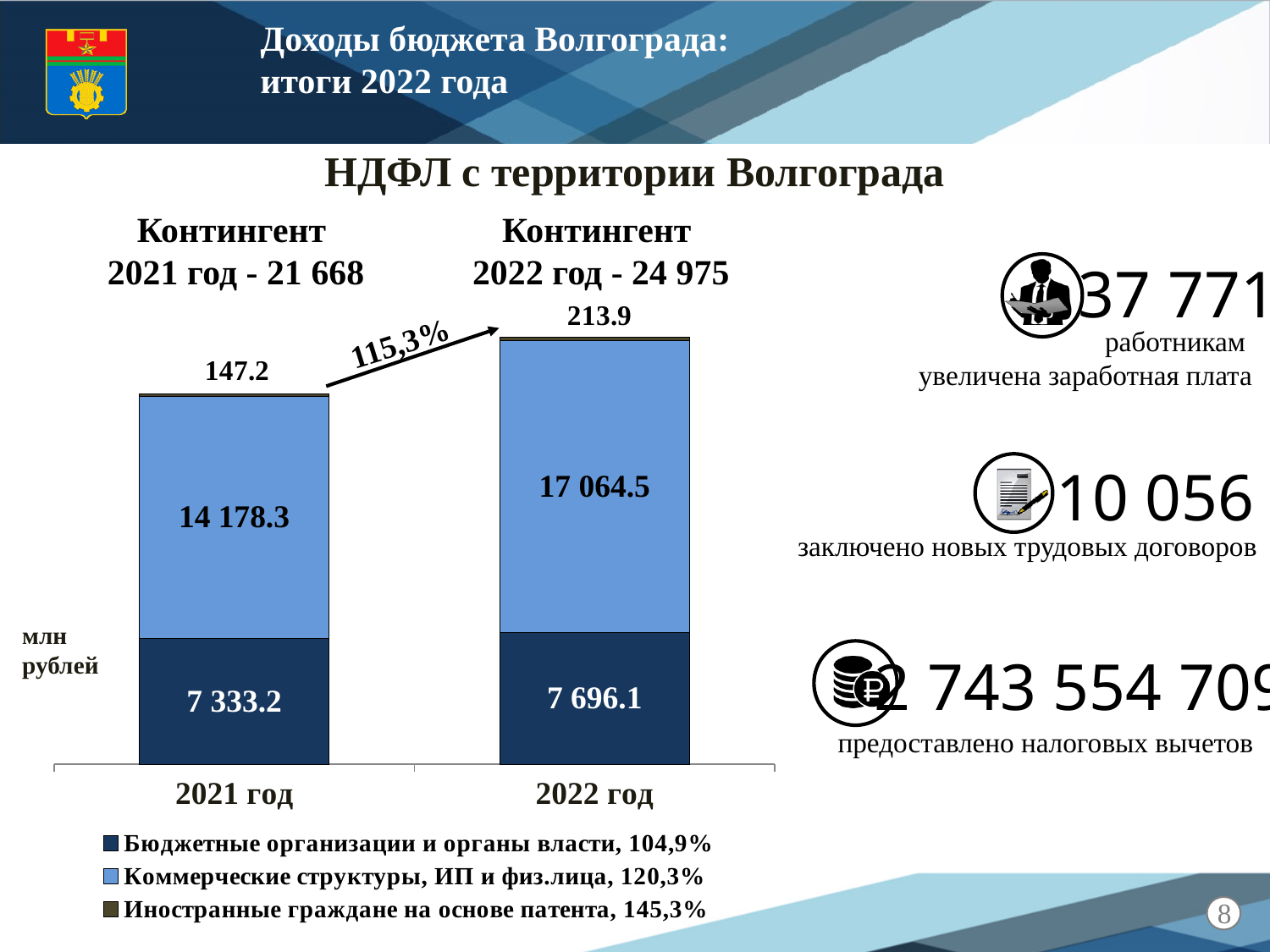
What kind of chart is shown on the slide? stacked bar chart Which series has the smallest value in 2022 год? Иностранные граждане на основе патента How many categories are shown on the x axis? 2 How many series does the legend list? 3 Which is larger: the Коммерческие структуры, ИП и физ.лица value in 2021 год or in 2022 год? 2022 год What is the difference between the Бюджетные организации и органы власти values for 2022 год and 2021 год? 362.9 What percentage is shown on the arrow between the 2021 and 2022 bars? 115,3% What is the difference between the Коммерческие структуры, ИП и физ.лица values for 2022 год and 2021 год? 2 886.2 What is the value for Иностранные граждане на основе патента in 2022 год? 213.9 What is the value for Иностранные граждане на основе патента in 2021 год? 147.2 What is the value for Коммерческие структуры, ИП и физ.лица in 2022 год? 17 064.5 What is the value for Бюджетные организации и органы власти in 2021 год? 7 333.2